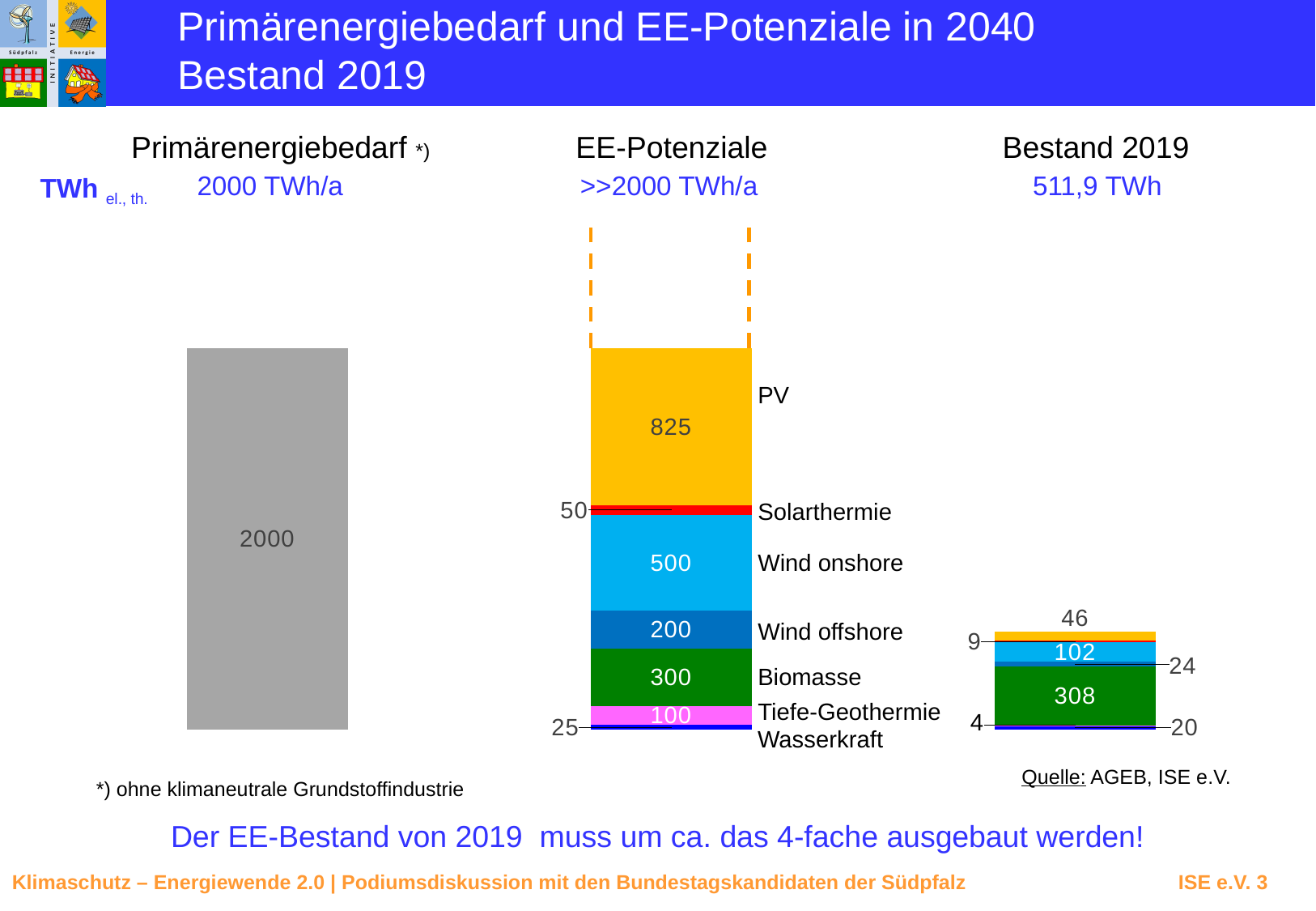
In the EE-Potenziale chart, which is larger, Biomasse or Tiefe-Geothermie? Biomasse In the EE-Potenziale chart, what is the value for Biomasse? 300 What kind of chart is the EE-Potenziale chart? Stacked bar chart In the EE-Potenziale chart, what is the value for Wind onshore? 500 In the EE-Potenziale chart, which segment has the lowest value? Wasserkraft In the EE-Potenziale chart, which segment has the highest value? PV In the EE-Potenziale chart, what is the value for Wasserkraft? 25 In the EE-Potenziale chart, what is the difference between Wind onshore and Wind offshore? 300 What is the value shown for the Primärenergiebedarf bar? 2000 What total is stated above the Bestand 2019 chart? 511,9 TWh How many segments make up the EE-Potenziale stacked bar? 7 In the EE-Potenziale chart, what is the value for PV? 825